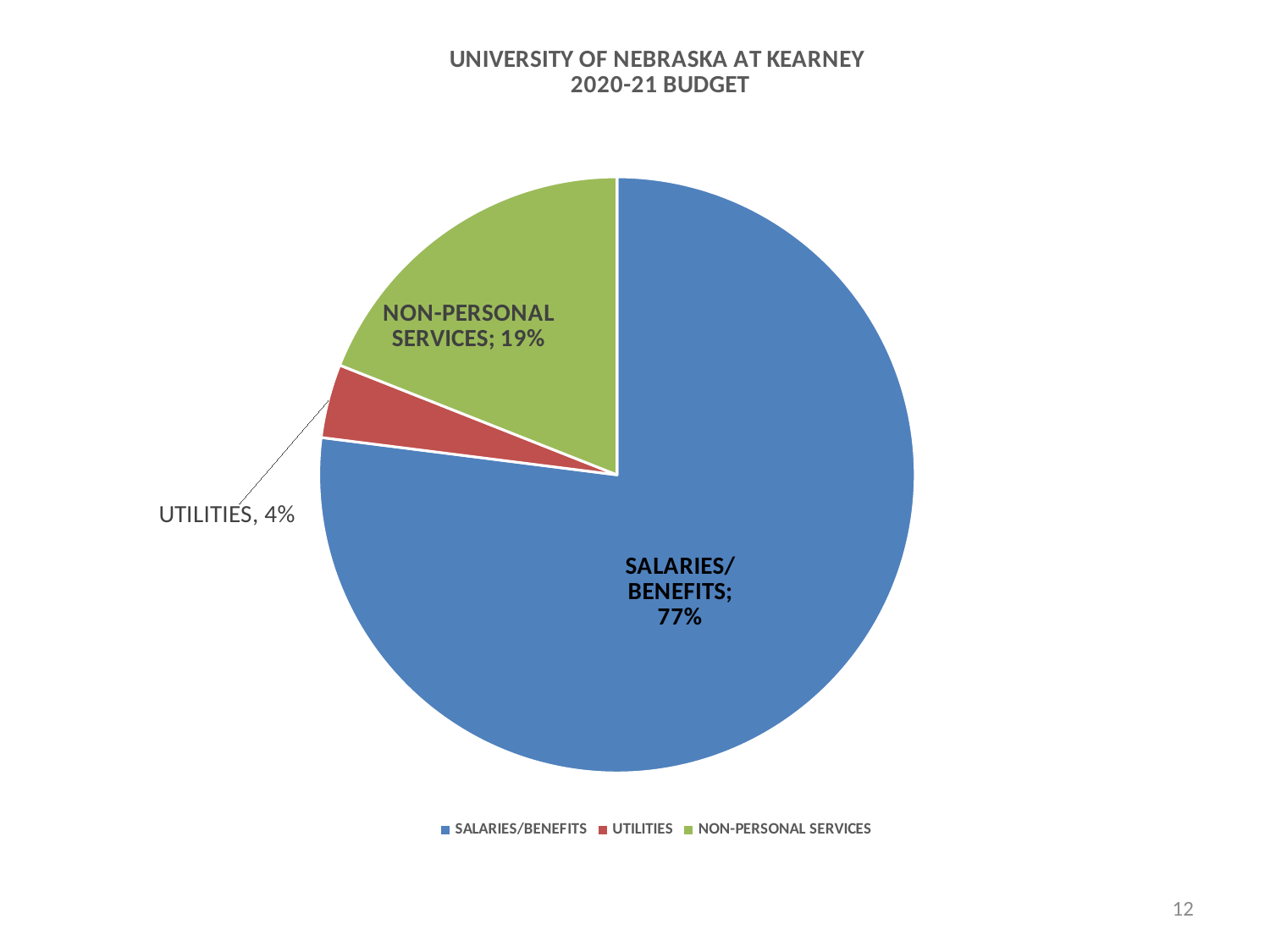
Which is larger, the share for Utilities or the share for Non-Personal Services? Non-Personal Services Which category has the largest share of the budget? Salaries/Benefits What is the title of the chart? University of Nebraska at Kearney 2020-21 Budget What kind of chart is shown on the slide? Pie chart What share of the budget is Salaries/Benefits? 77% What share of the budget is Utilities? 4% What is the difference in percentage points between Non-Personal Services and Utilities? 15 What colour is the Utilities slice? Red What is the difference in percentage points between Salaries/Benefits and Non-Personal Services? 58 What share of the budget is Non-Personal Services? 19% Which category has the smallest share of the budget? Utilities How many categories are shown in the pie chart? 3